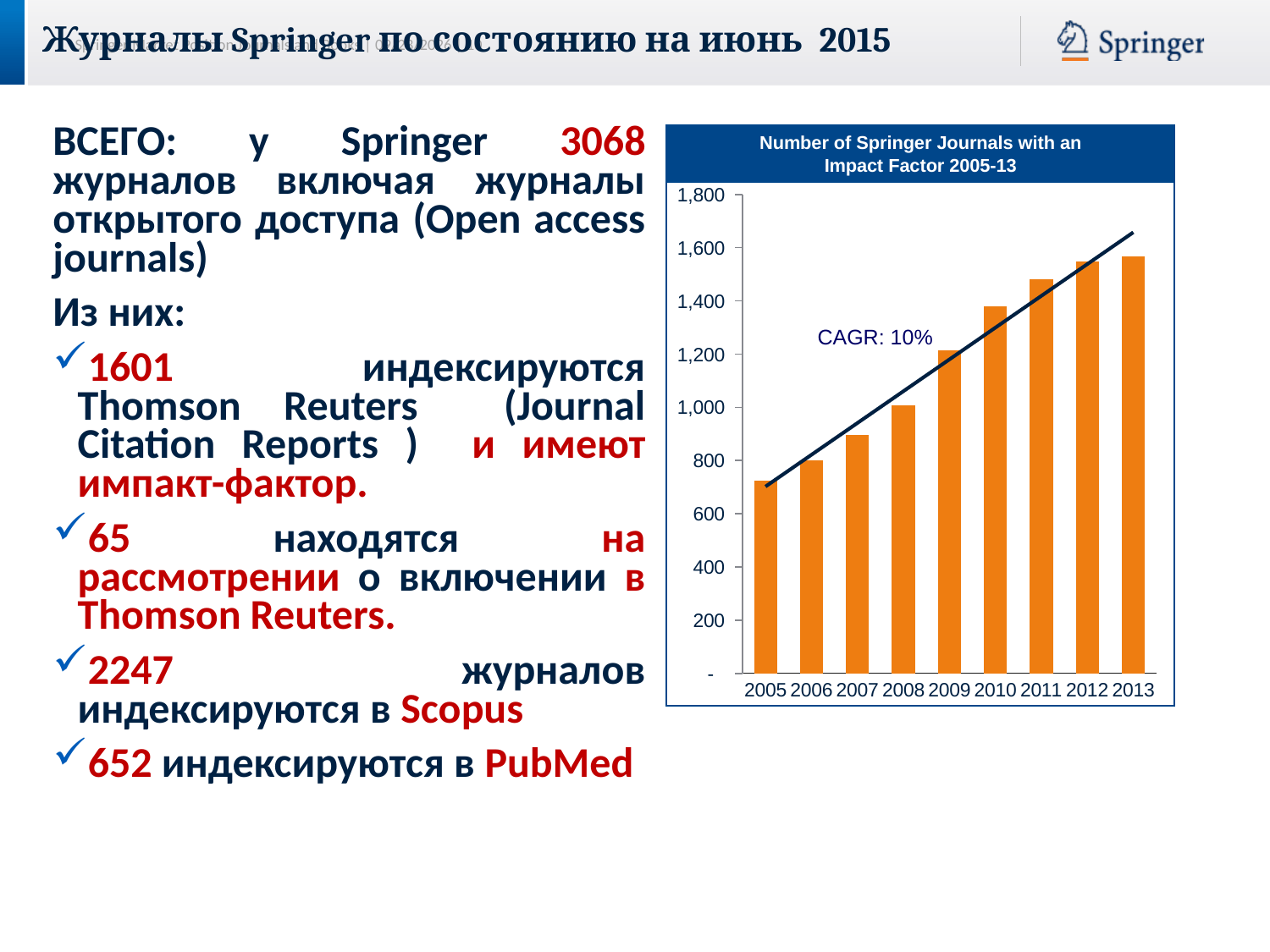
Is the value for 2005 greater or less than 800? less Which year has the lowest number of Springer journals with an Impact Factor? 2005 How many years are plotted on the x axis of the chart? 9 What kind of chart is shown on the slide? bar chart Is the value for 2007 greater or less than 1,000? less Which year has the larger value, 2007 or 2010? 2010 Is the value for 2010 greater or less than 1,200? greater What is the title of the chart? Number of Springer Journals with an Impact Factor 2005-13 Do the values rise or fall from 2005 to 2013? rise What CAGR is annotated on the chart? 10%